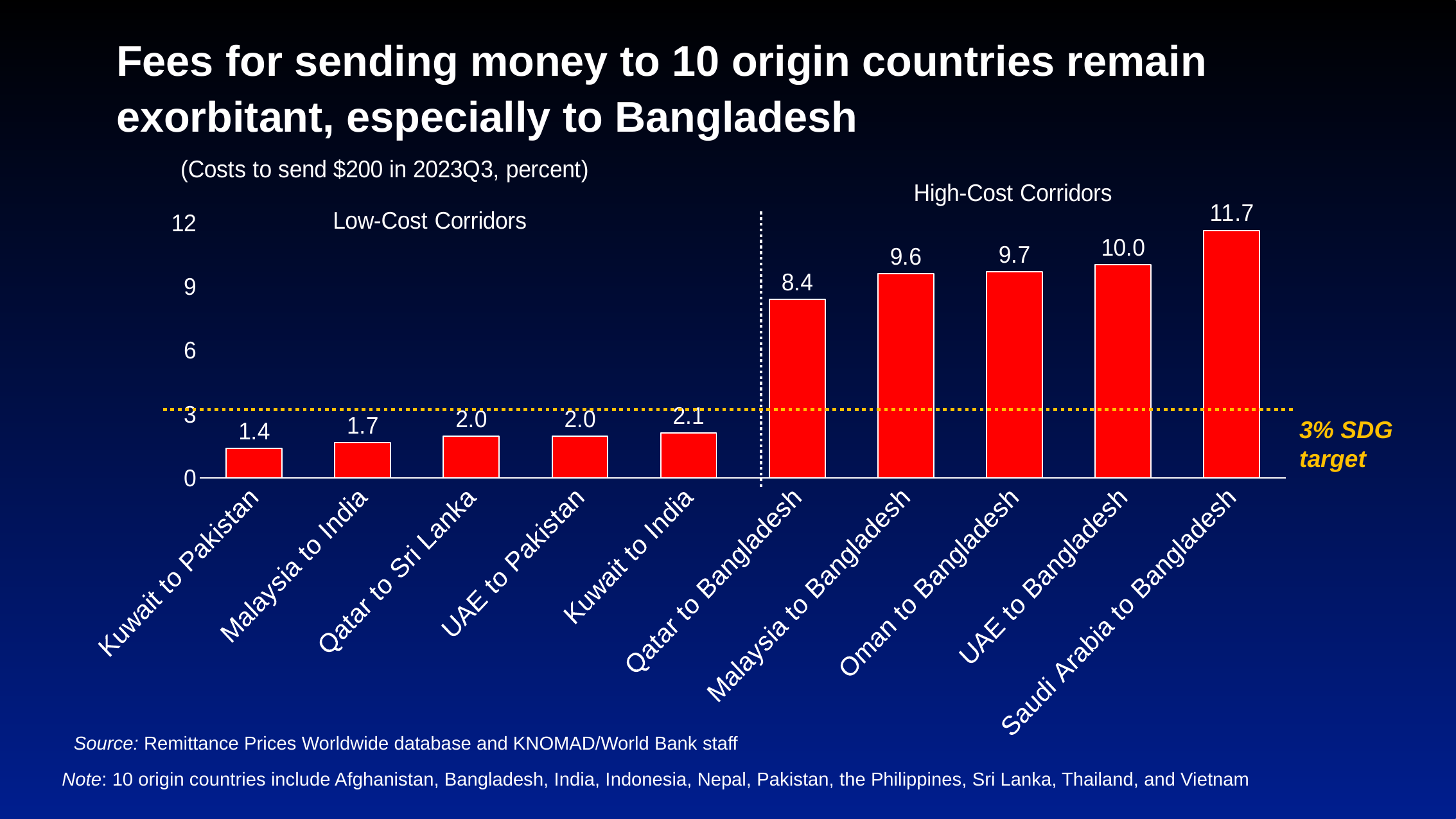
What is the cost to send $200 from Saudi Arabia to Bangladesh? 11.7 How many corridors are shown in the chart? 10 What is the cost to send $200 from Qatar to Bangladesh? 8.4 Which is larger, the cost for Malaysia to Bangladesh or the cost for Oman to Bangladesh? Oman to Bangladesh Which corridor has the highest cost? Saudi Arabia to Bangladesh What does the yellow dotted horizontal line represent? 3% SDG target Which corridor has the lowest cost? Kuwait to Pakistan What are the two groups of corridors labelled on the chart? Low-Cost Corridors and High-Cost Corridors What kind of chart is shown on the slide? bar chart What is the cost to send $200 from Kuwait to Pakistan? 1.4 What is the difference between the cost for UAE to Bangladesh and the cost for UAE to Pakistan? 8.0 Is the value for Kuwait to India greater or less than 3? less